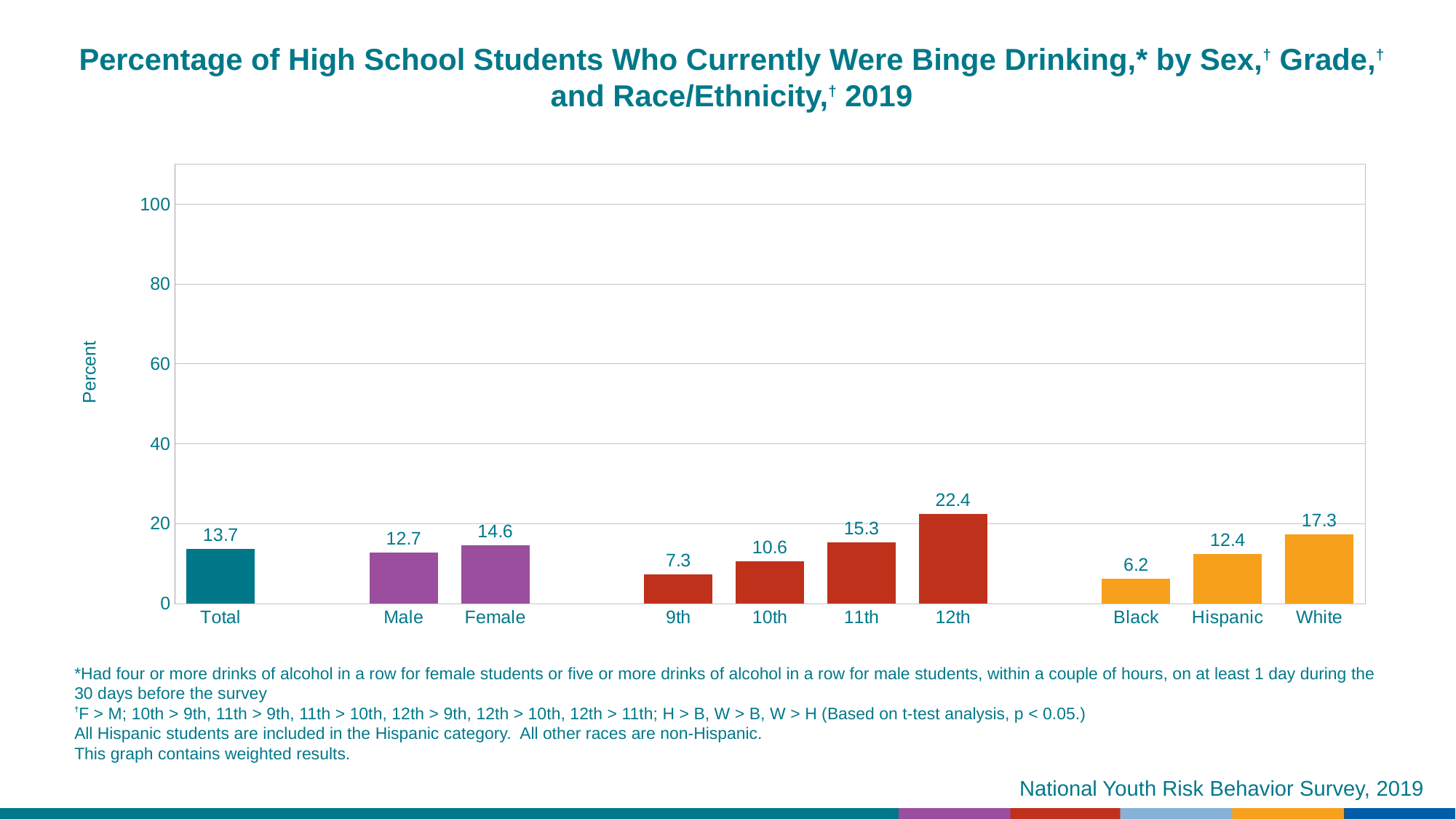
What is the value for Black students? 6.2 What is the difference between the values for 12th and 9th grade? 15.1 What is the value for Total? 13.7 Which category has the lowest value? Black Is the value for 11th grade greater or less than 20? less How many categories are shown on the x axis? 10 Which category has the highest value? 12th What kind of chart is this? bar chart What is the difference between the values for Female and Male? 1.9 What is the value for 12th grade? 22.4 What is the value for Female? 14.6 Which is larger, the value for White or the value for Hispanic? White